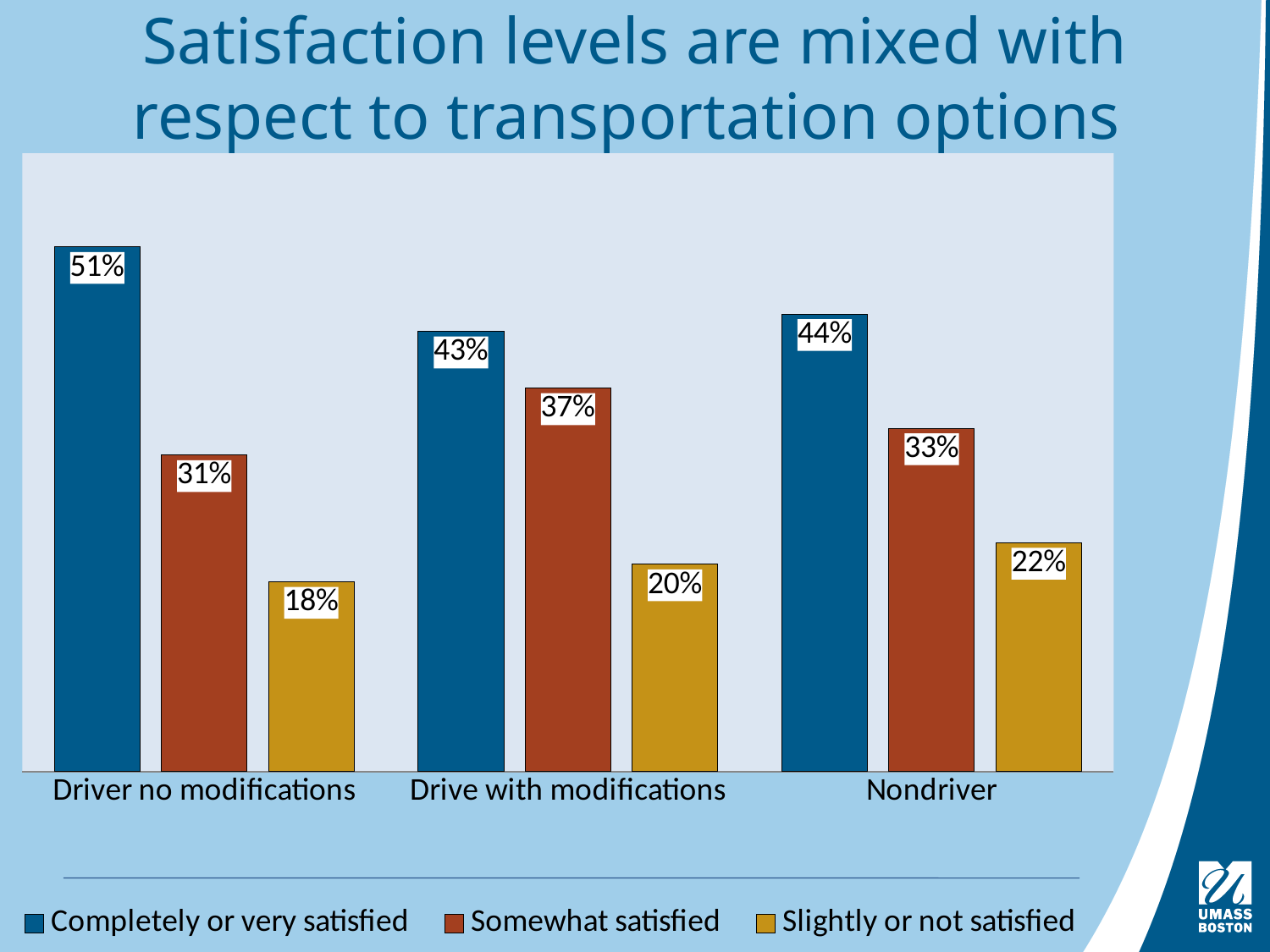
Which category has the lowest value for Slightly or not satisfied? Driver no modifications What kind of chart is shown on the slide? Bar chart Which category has the highest value for Completely or very satisfied? Driver no modifications Which series is shown in the gold/yellow colour? Slightly or not satisfied What is the difference between the Completely or very satisfied values for Driver no modifications and Nondriver? 7% How many categories are shown on the x axis? 3 How many series does the legend list? 3 What percentage of drivers with no modifications are completely or very satisfied? 51% What percentage of nondrivers are slightly or not satisfied? 22% What is the value for Somewhat satisfied in the Drive with modifications category? 37% What is the difference between the Somewhat satisfied and Slightly or not satisfied values for Nondriver? 11% Which is larger: the Somewhat satisfied value for Drive with modifications or for Nondriver? Drive with modifications